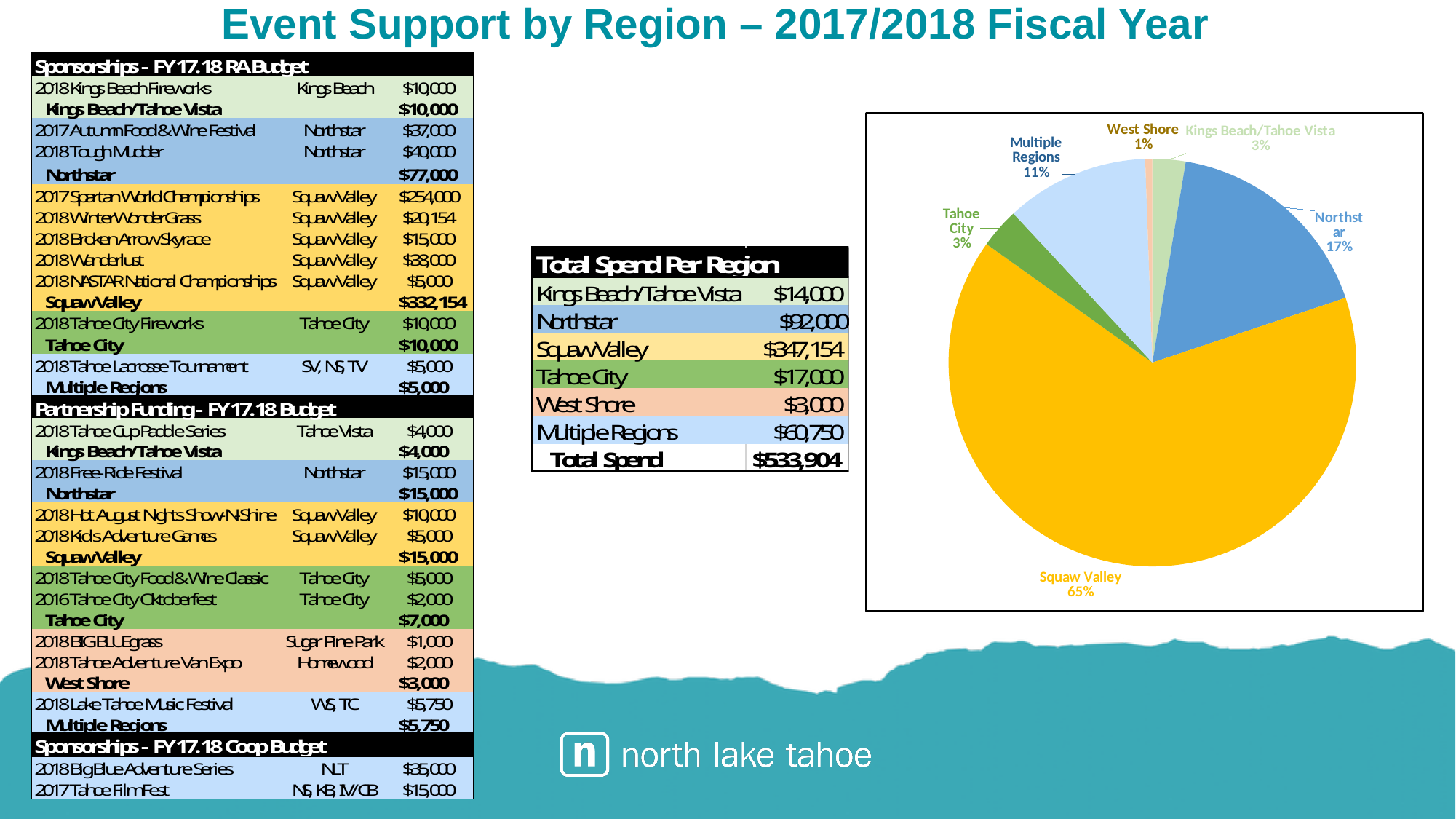
What kind of chart is shown on the right side of the slide? pie chart What colour is the Squaw Valley slice in the pie chart? yellow What percentage share does Northstar have in the pie chart? 17% Which region has the largest slice in the pie chart? Squaw Valley What percentage share does Squaw Valley have in the pie chart? 65% In the pie chart, what is the difference in percentage points between Squaw Valley and Northstar? 48 What percentage share does Tahoe City have in the pie chart? 3% In the pie chart, which slice is larger: Northstar or Multiple Regions? Northstar How many slices does the pie chart have? 6 Which region has the smallest slice in the pie chart? West Shore